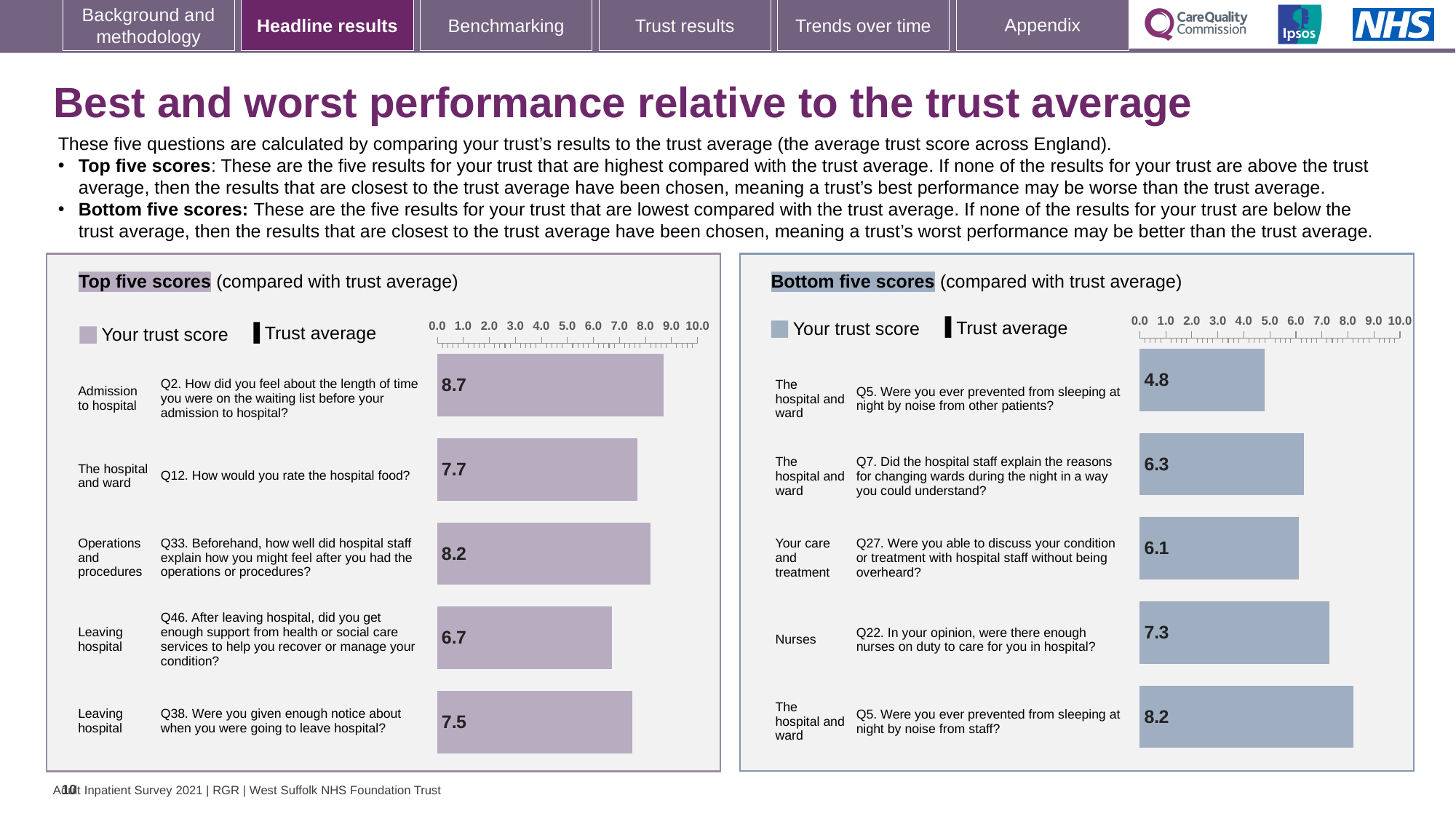
In the Bottom five scores chart, which question has the lowest trust score? Q5. Were you ever prevented from sleeping at night by noise from other patients? In the Bottom five scores chart, what is the trust score for Q22 about whether there were enough nurses on duty? 7.3 In the Bottom five scores chart, which has the larger trust score: Q7 about explaining reasons for changing wards, or Q27 about discussing your condition without being overheard? Q7 In the Bottom five scores chart, which question has the highest trust score? Q5. Were you ever prevented from sleeping at night by noise from staff? In the Top five scores chart, what is the trust score for Q2 about the length of time on the waiting list before admission? 8.7 What kind of chart is the Top five scores chart? Bar chart In the Top five scores chart, what is the difference between the trust scores for Q2 (8.7) and Q46 (6.7)? 2.0 In the Top five scores chart, which question has the lowest trust score? Q46. After leaving hospital, did you get enough support from health or social care services to help you recover or manage your condition? In the Top five scores chart, which question has the highest trust score? Q2. How did you feel about the length of time you were on the waiting list before your admission to hospital? In the Top five scores chart, what is the trust score for Q12. How would you rate the hospital food? 7.7 In the Bottom five scores chart, what is the trust score for Q5 about being prevented from sleeping at night by noise from other patients? 4.8 How many questions are plotted in the Bottom five scores chart? 5